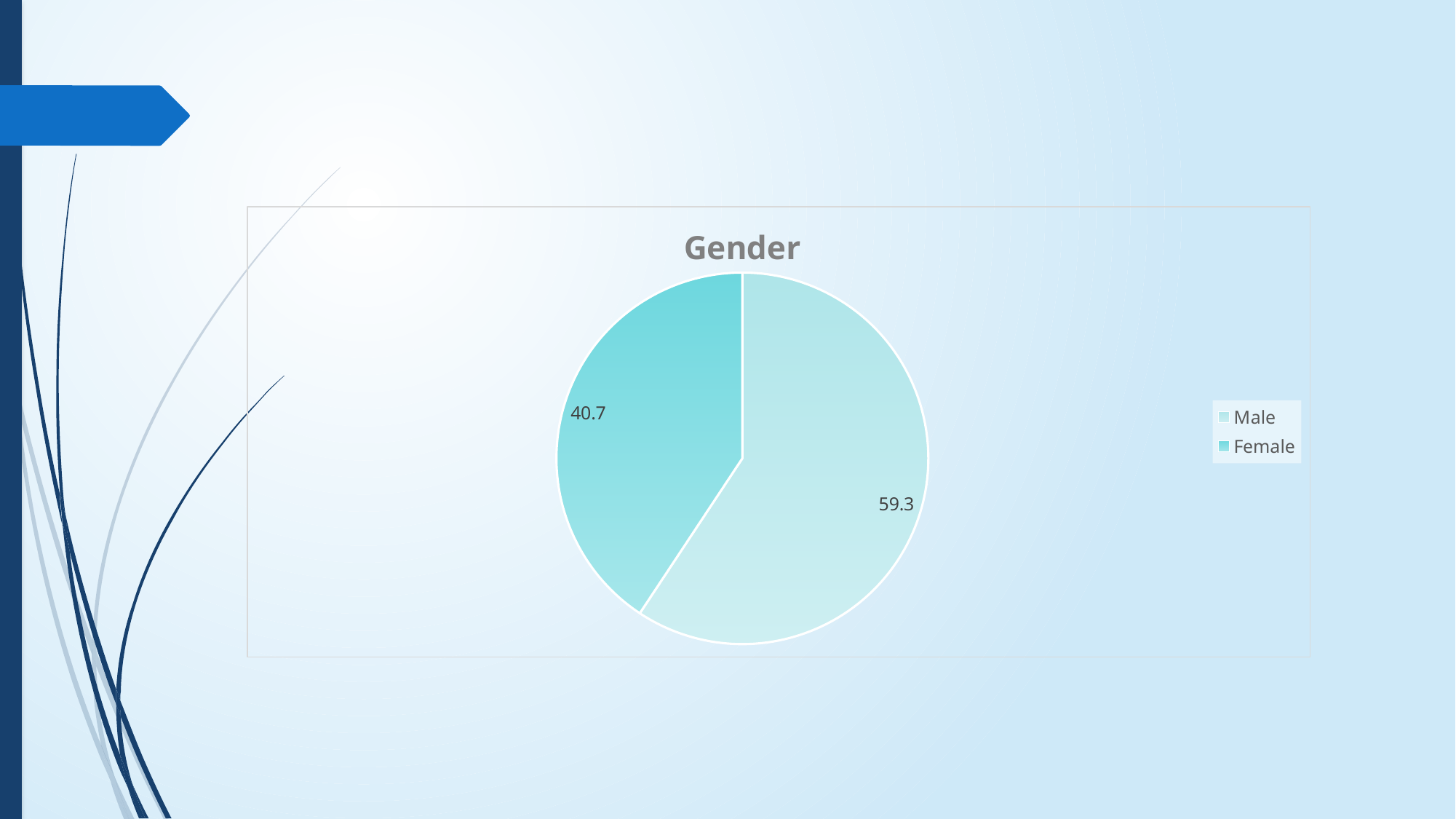
What is the value for Male in the Gender pie chart? 59.3 What is the total of the two values shown in the Gender pie chart? 100 Which category has the smallest slice in the Gender pie chart? Female What is the title of the chart on the slide? Gender What is the value for Female in the Gender pie chart? 40.7 Which category has the largest slice in the Gender pie chart? Male What kind of chart is shown on the slide? Pie chart What are the legend entries in the Gender pie chart? Male, Female Which is larger in the Gender pie chart, Male or Female? Male How many categories are shown in the Gender pie chart? 2 What is the difference between the Male and Female values in the Gender pie chart? 18.6